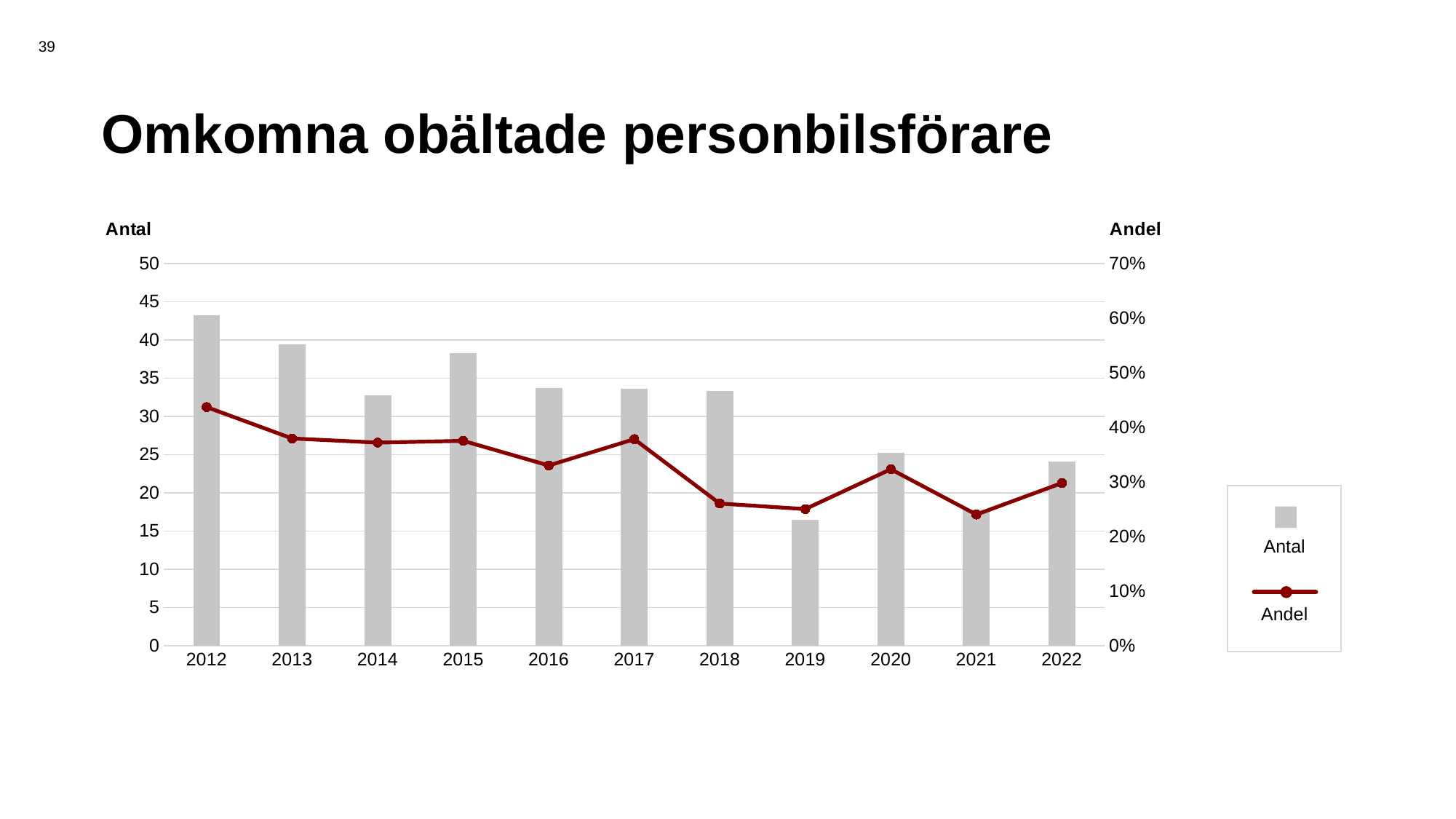
Which year has the highest Antal bar? 2012 How many years are shown on the x axis of the chart? 11 Is the Andel value for 2018 greater or less than 30%? less Is the Antal value for 2019 greater or less than 20? less Which year has the larger Antal value, 2019 or 2020? 2020 Does the Antal series generally rise or fall from 2012 to 2022? fall What kind of chart is shown on the slide? A combined bar and line chart Is the Antal value for 2012 greater or less than 40? greater What is the title of the chart on the slide? Omkomna obältade personbilsförare Which year has the highest Andel value? 2012 How many series does the legend list? 2